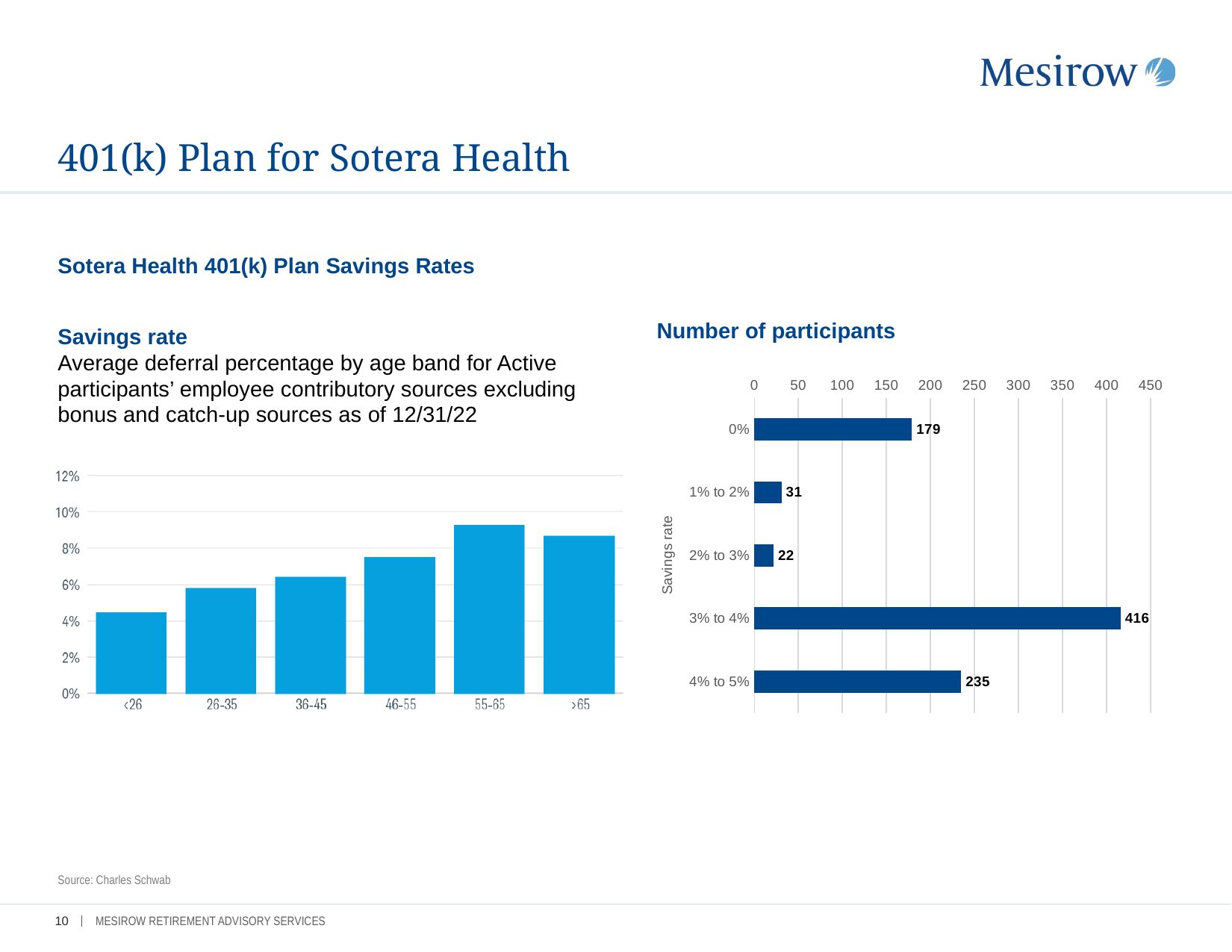
How many savings rate bands are shown in the Number of participants chart? 5 In the Number of participants chart, which savings rate band has the fewest participants? 2% to 3% In the Savings rate chart on the left, which age band has the lowest average deferral percentage? <26 What kind of chart is the Number of participants chart? Bar chart In the Number of participants chart, which band has more participants: 0% or 4% to 5%? 4% to 5% In the Number of participants chart, which savings rate band has the most participants? 3% to 4% In the Savings rate chart on the left, is the value for the 55-65 age band greater or less than 8%? greater In the Number of participants chart, how many participants have a savings rate of 0%? 179 In the Number of participants chart, what is the difference between the number of participants in the 3% to 4% band and the 4% to 5% band? 181 In the Savings rate chart on the left, is the value for the <26 age band greater or less than 6%? less In the Savings rate chart on the left, which age band has the highest average deferral percentage? 55-65 In the Number of participants chart, how many participants have a savings rate of 3% to 4%? 416